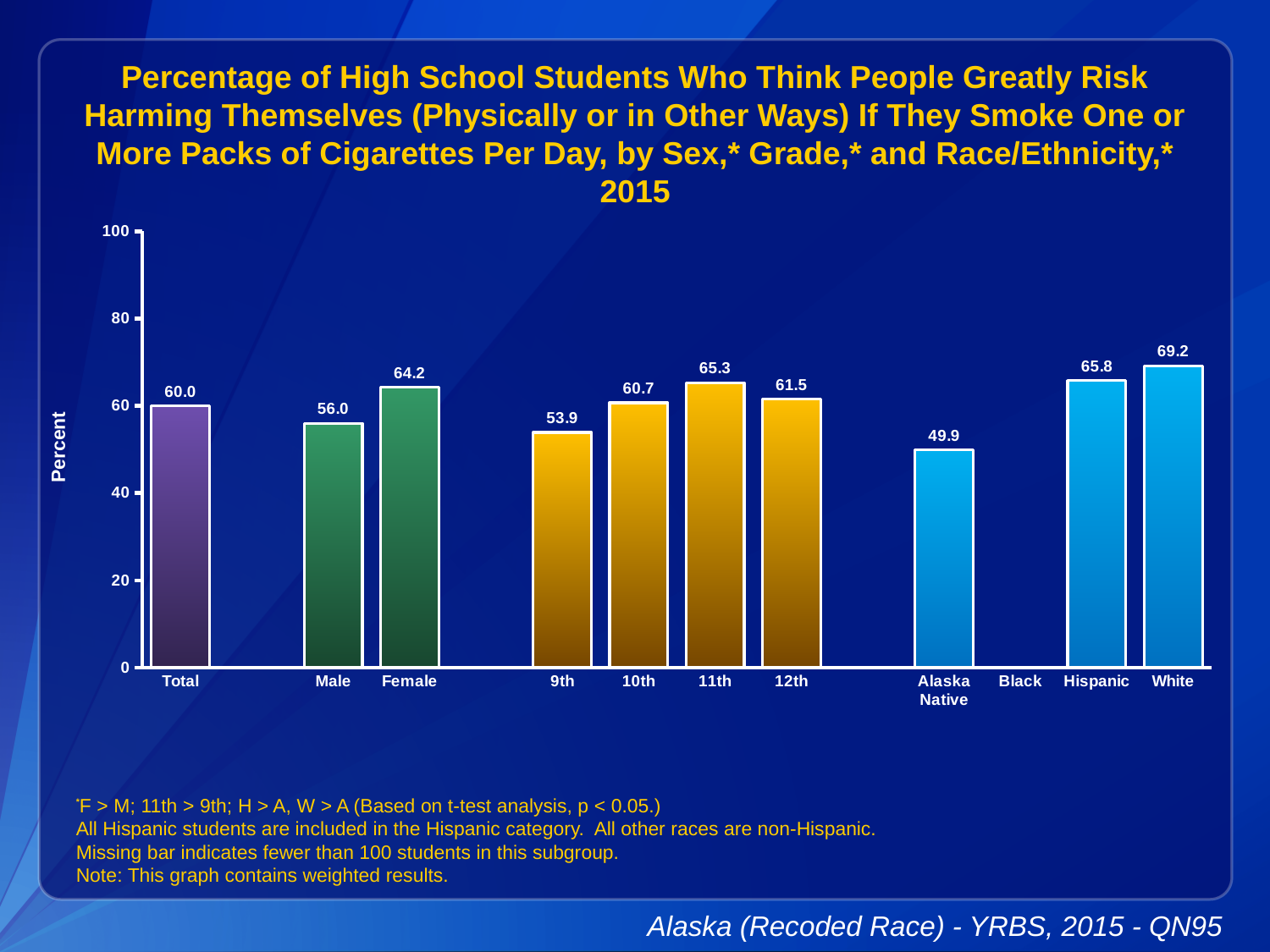
Which category has no bar shown? Black Which category has the highest value? White What is the value for Female? 64.2 What is the value for 11th grade? 65.3 What is the difference between the Female and Male values? 8.2 Which category has the lowest value among the bars shown? Alaska Native What is the value for Alaska Native? 49.9 What kind of chart is shown? bar chart Is the value for 9th grade greater or less than 60? less Which is larger, the value for 10th grade or the value for 12th grade? 12th How many bars are plotted on the chart? 11 What is the label on the y axis? Percent